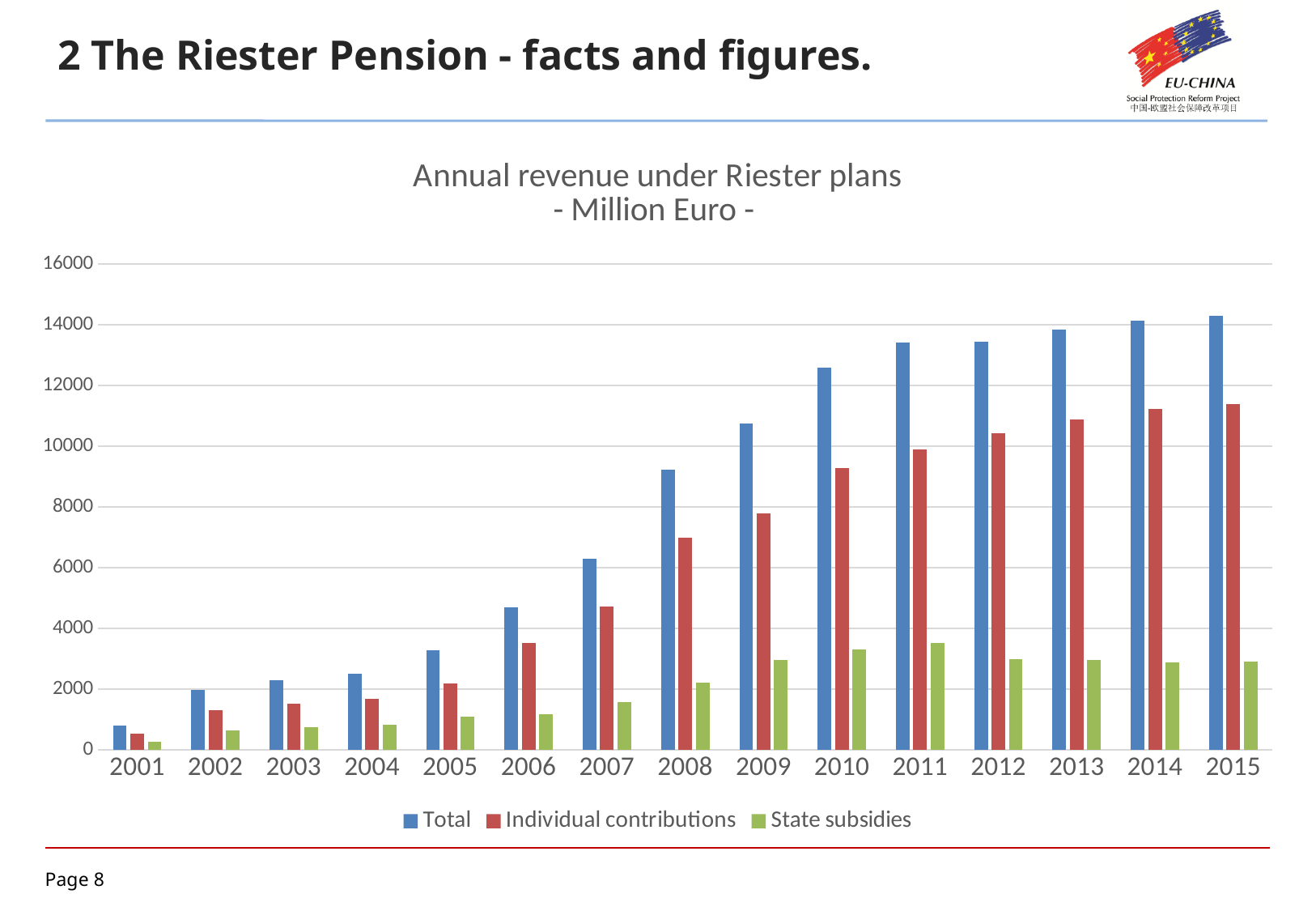
How many years are shown on the x axis? 15 Does the Total value rise or fall from 2001 to 2015? rise Is the Total value for 2010 greater or less than 12000? greater Which is larger in 2007: Individual contributions or State subsidies? Individual contributions Which year has the lowest Total value? 2001 What is the title of the chart? Annual revenue under Riester plans - Million Euro - Which year has the highest State subsidies value? 2011 What type of chart is shown on the slide? bar chart Is the State subsidies value for 2011 greater or less than 4000? less Which year has the highest Total value? 2015 How many series does the legend list? 3 Is the Individual contributions value for 2009 greater or less than 8000? less